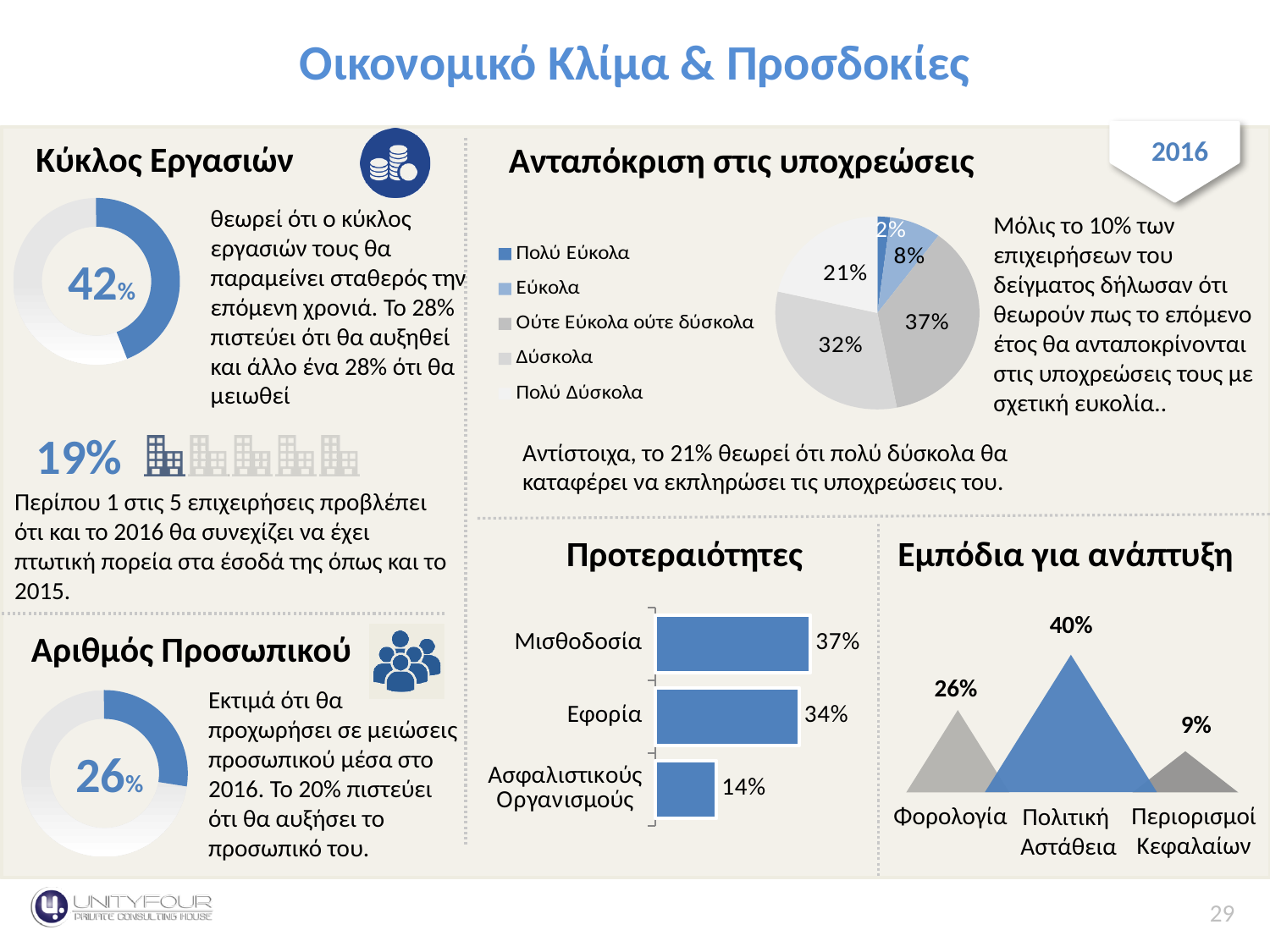
In the 'Προτεραιότητες' chart, which category has the highest value? Μισθοδοσία In the 'Εμπόδια για ανάπτυξη' chart, what is the value for 'Πολιτική Αστάθεια'? 40% In the 'Προτεραιότητες' chart, what is the value for 'Εφορία'? 34% In the 'Εμπόδια για ανάπτυξη' chart, which category has the lowest value? Περιορισμοί Κεφαλαίων How many entries does the legend of the 'Ανταπόκριση στις υποχρεώσεις' pie chart list? 5 In the 'Ανταπόκριση στις υποχρεώσεις' pie chart, what percentage is shown for 'Πολύ Δύσκολα'? 21% In the 'Προτεραιότητες' chart, what is the difference between 'Μισθοδοσία' and 'Ασφαλιστικούς Οργανισμούς'? 23% In the 'Ανταπόκριση στις υποχρεώσεις' pie chart, which category has the smallest share? Πολύ Εύκολα In the 'Ανταπόκριση στις υποχρεώσεις' pie chart, what percentage is shown for 'Ούτε Εύκολα ούτε δύσκολα'? 37% In the 'Εμπόδια για ανάπτυξη' chart, which is larger: 'Φορολογία' or 'Περιορισμοί Κεφαλαίων'? Φορολογία What type of chart is used for 'Προτεραιότητες'? Bar chart In the 'Ανταπόκριση στις υποχρεώσεις' pie chart, what is the difference between the 'Δύσκολα' and 'Εύκολα' shares? 24%